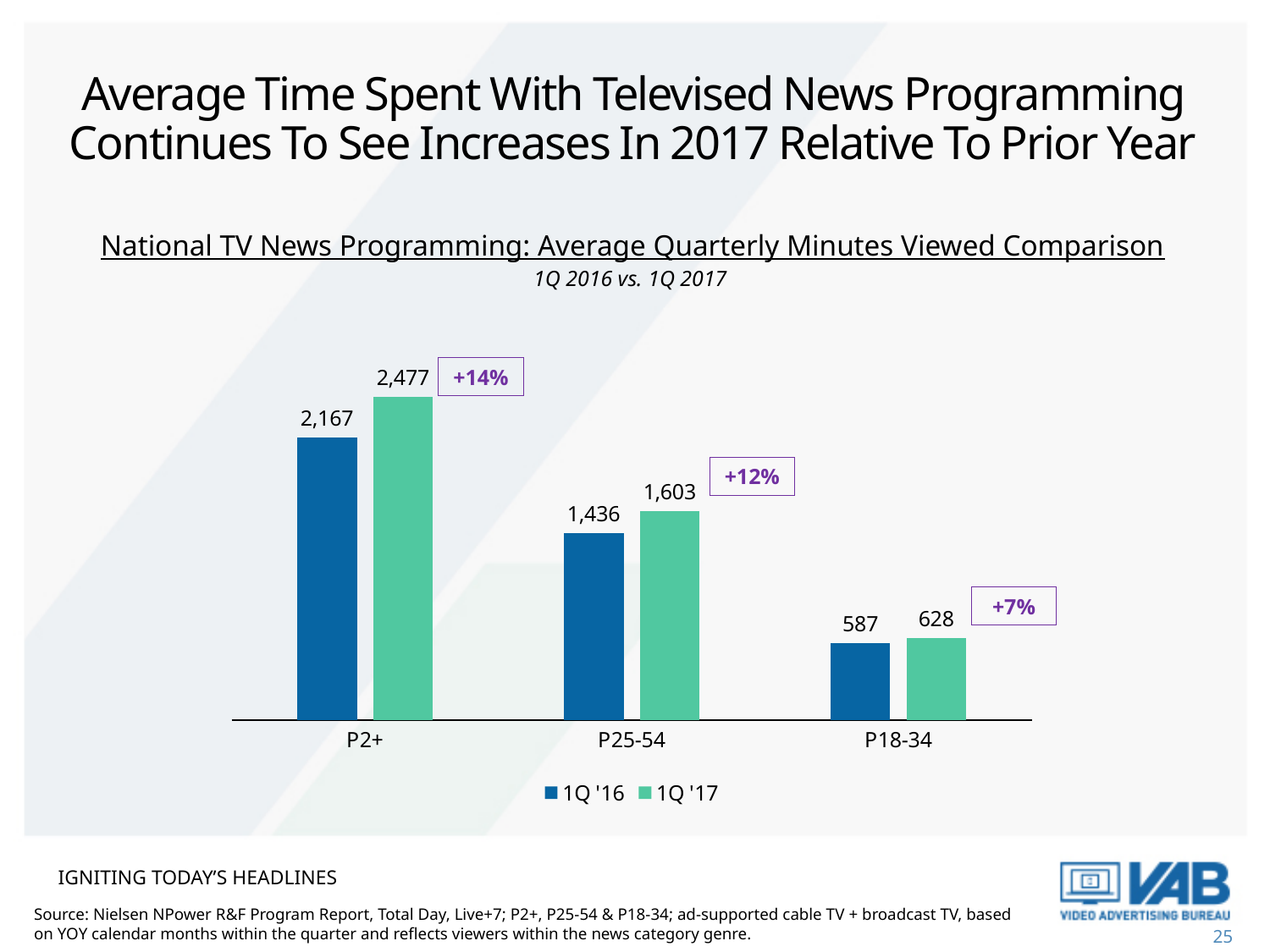
What is the difference between the 1Q '17 and 1Q '16 values for P18-34? 41 What is the 1Q '16 value for P2+? 2,167 What percentage change is shown for P25-54? +12% How many series does the legend list? 2 What is the 1Q '17 value for P18-34? 628 Which demographic has the lowest 1Q '16 value? P18-34 What is the 1Q '17 value for P25-54? 1,603 Which demographic has the highest 1Q '17 value? P2+ What kind of chart is shown on the slide? Bar chart How many demographic categories are shown on the x axis? 3 What is the difference between the 1Q '17 and 1Q '16 values for P2+? 310 Which is larger for P25-54: the 1Q '16 value or the 1Q '17 value? 1Q '17